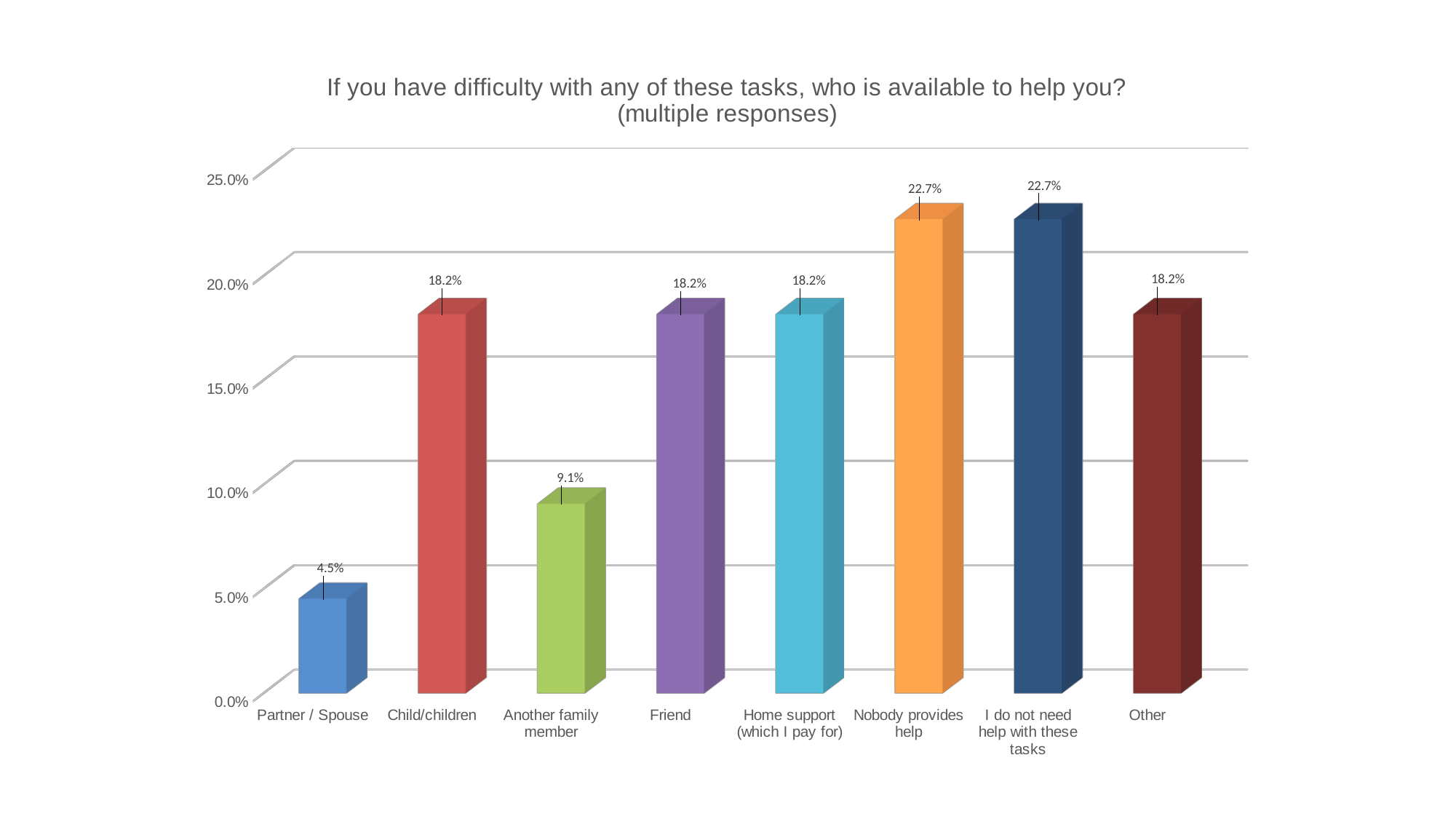
What percentage of respondents said a Partner / Spouse is available to help them? 4.5% Which category has the lowest value in the chart? Partner / Spouse What is the difference between the values for Child/children and Partner / Spouse? 13.7% What is the difference between the values for 'Nobody provides help' and 'Friend'? 4.5% What is the value for 'Home support (which I pay for)'? 18.2% What percentage is shown for 'Another family member'? 9.1% What is the title of the chart? If you have difficulty with any of these tasks, who is available to help you? (multiple responses) Is the value for 'Another family member' greater or less than 10.0%? less Which is larger, the value for 'I do not need help with these tasks' or the value for 'Other'? I do not need help with these tasks What kind of chart is shown on the slide? Bar chart What is the value shown for 'Nobody provides help'? 22.7% How many categories are shown on the x axis of the chart? 8